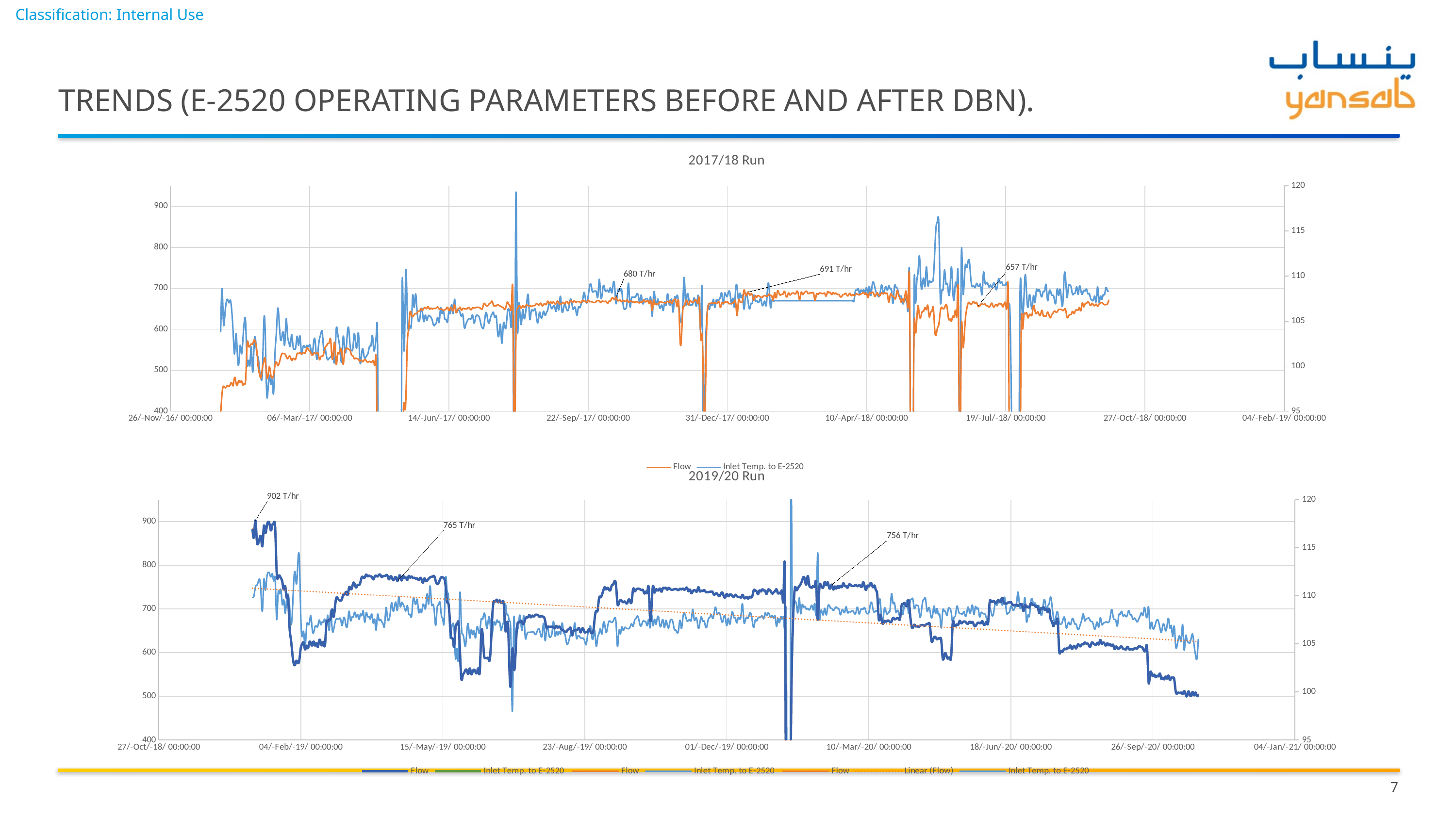
What is the maximum value shown on the right-hand axis of the 2019/20 Run chart? 120 In the 2017/18 Run chart, what is the lowest annotated flow value? 657 T/hr What is the title of the upper chart on the slide? 2017/18 Run In the 2017/18 Run chart, what is the difference between the 691 T/hr and 657 T/hr annotated flow values? 34 T/hr How many flow values are annotated with data labels in the 2019/20 Run chart? 3 In the 2019/20 Run chart, what is the difference between the 902 T/hr and 765 T/hr annotated flow values? 137 T/hr In the 2017/18 Run chart, which annotated flow value is larger, 680 T/hr or 691 T/hr? 691 T/hr In the 2019/20 Run chart, is the Flow value at the end of the run (around late September 2020) greater or less than 600? less In the 2019/20 Run chart, what is the highest annotated flow value? 902 T/hr What type of chart is used for the 2017/18 Run and 2019/20 Run? Line chart How many series does the legend of the 2017/18 Run chart list? 2 In the 2019/20 Run chart, does the dotted Linear (Flow) trendline rise or fall along the x axis? Fall